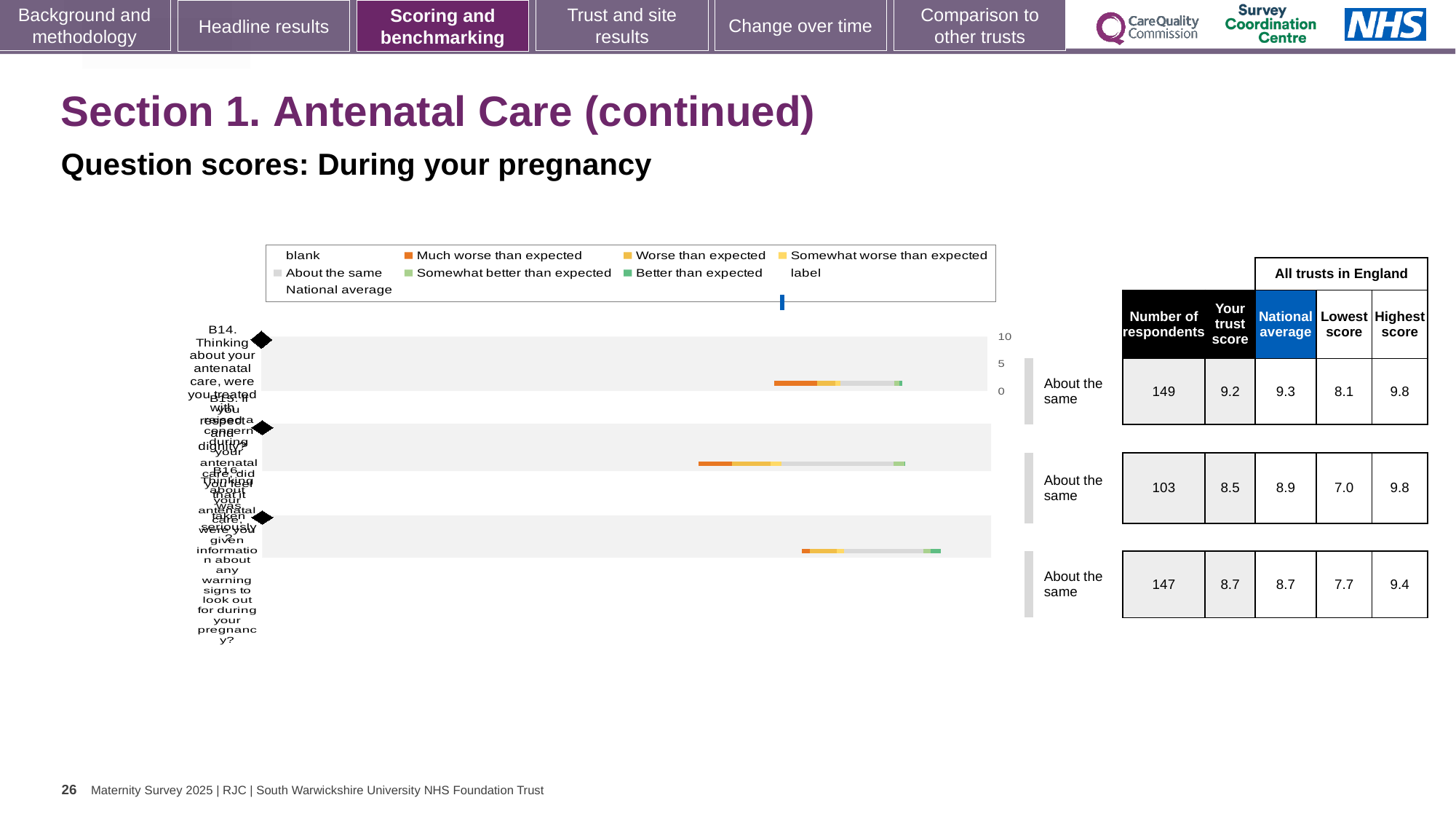
What is the national average for question B14 (the first row)? 9.3 What is the difference between the highest score and the lowest score for question B14? 1.7 What colour represents 'Much worse than expected' in the legend? orange What is the 'Your trust score' for question B14 (the first row)? 9.2 How many respondents are listed for the second row of the table? 103 Which row has the highest number of respondents? the first row, B14 (149) What kind of chart is shown on the slide? bar chart For the second row, which is larger: the trust score or the national average? the national average (8.9) What benchmark category is shown for all three questions? About the same Which row has the lowest 'Lowest score' value? the second row (7.0) What is the highest score across all trusts in England for the third row? 9.4 How many questions (bars) are plotted in the chart? 3